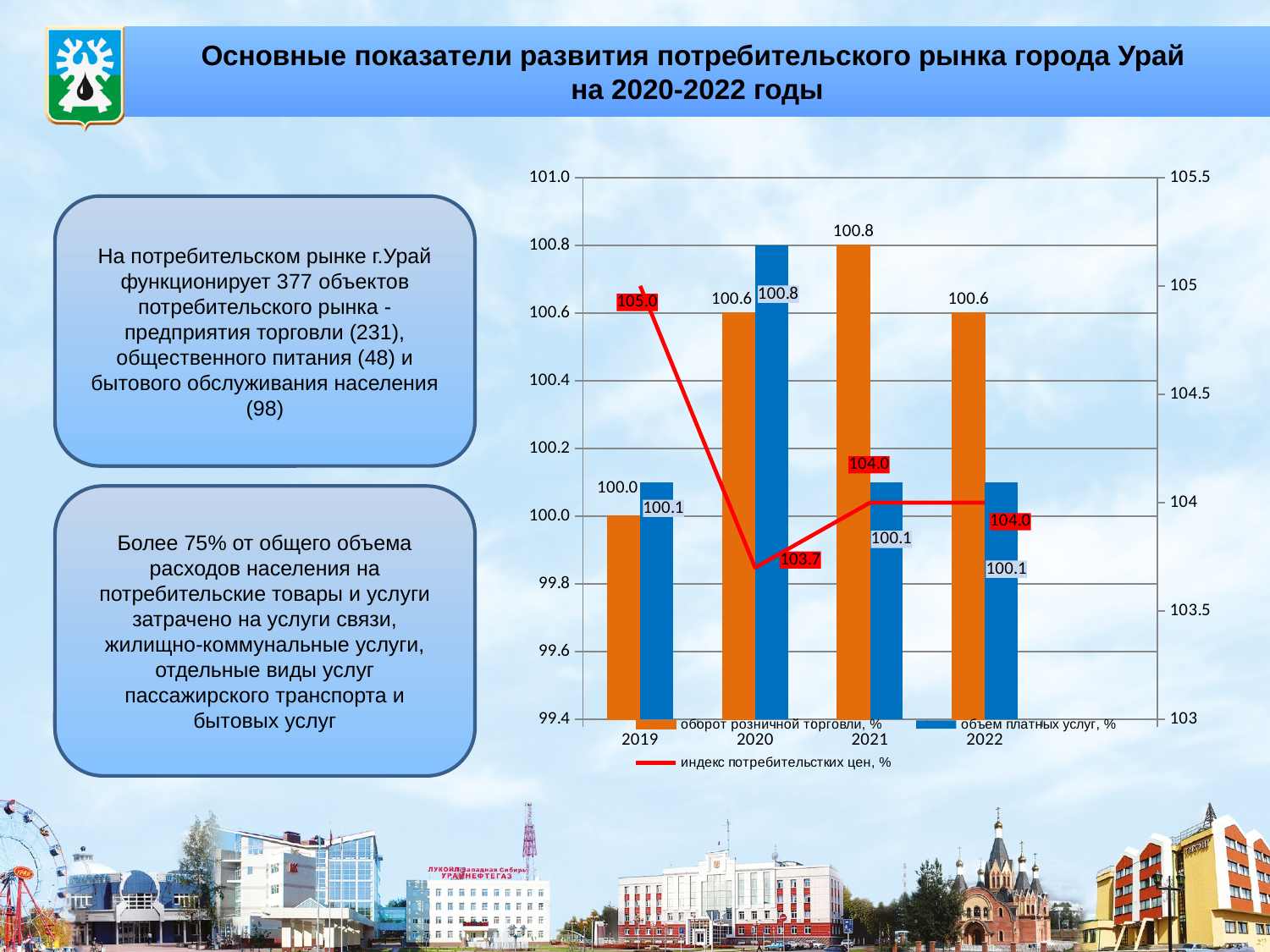
In which year is оборот розничной торговли, % the highest? 2021 In which year is индекс потребительских цен, % the lowest? 2020 What is the value of оборот розничной торговли, % for 2021? 100.8 Which is larger in 2020: оборот розничной торговли, % or объем платных услуг, %? объем платных услуг, % What is the value of индекс потребительских цен, % for 2020? 103.7 How many series does the chart legend list? 3 What is the value of индекс потребительских цен, % for 2019? 105.0 What kind of chart is shown on the slide? Combined bar and line chart Which colour represents объем платных услуг, % in the chart? Blue What is the value of объем платных услуг, % for 2020? 100.8 What is the difference between оборот розничной торговли, % in 2021 and in 2019? 0.8 How many years are shown on the x axis of the chart? 4